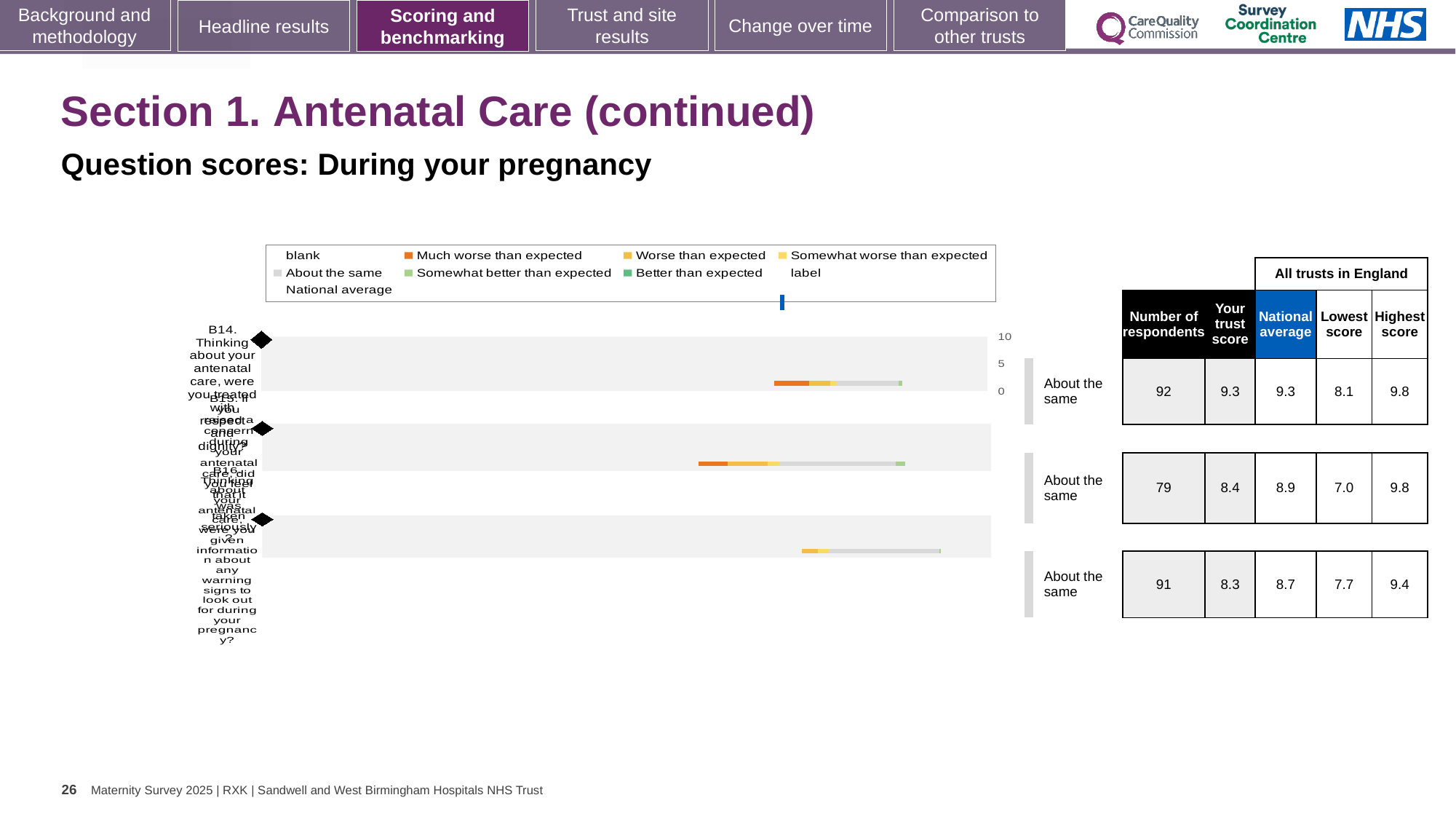
What benchmark category is shown next to each of the three bars? About the same Which row of the table has the highest trust score? the first row, B14 (9.3) What is the national average for the second row of the table? 8.9 What is the trust score for question B14 (the first row) in the table? 9.3 What is the difference between the national average and the trust score in the second row of the table? 0.5 How many questions (bars) are plotted in the chart? 3 What is the lowest score among all trusts in England for the third row of the table? 7.7 Is the trust score in the third row (8.3) larger or smaller than its national average (8.7)? smaller According to the table, how many respondents answered question B14 (the first row)? 92 What kind of chart is shown on the slide? bar chart Which row of the table has the fewest respondents? the second row (79) What is the highest score among all trusts in England for the second row of the table? 9.8